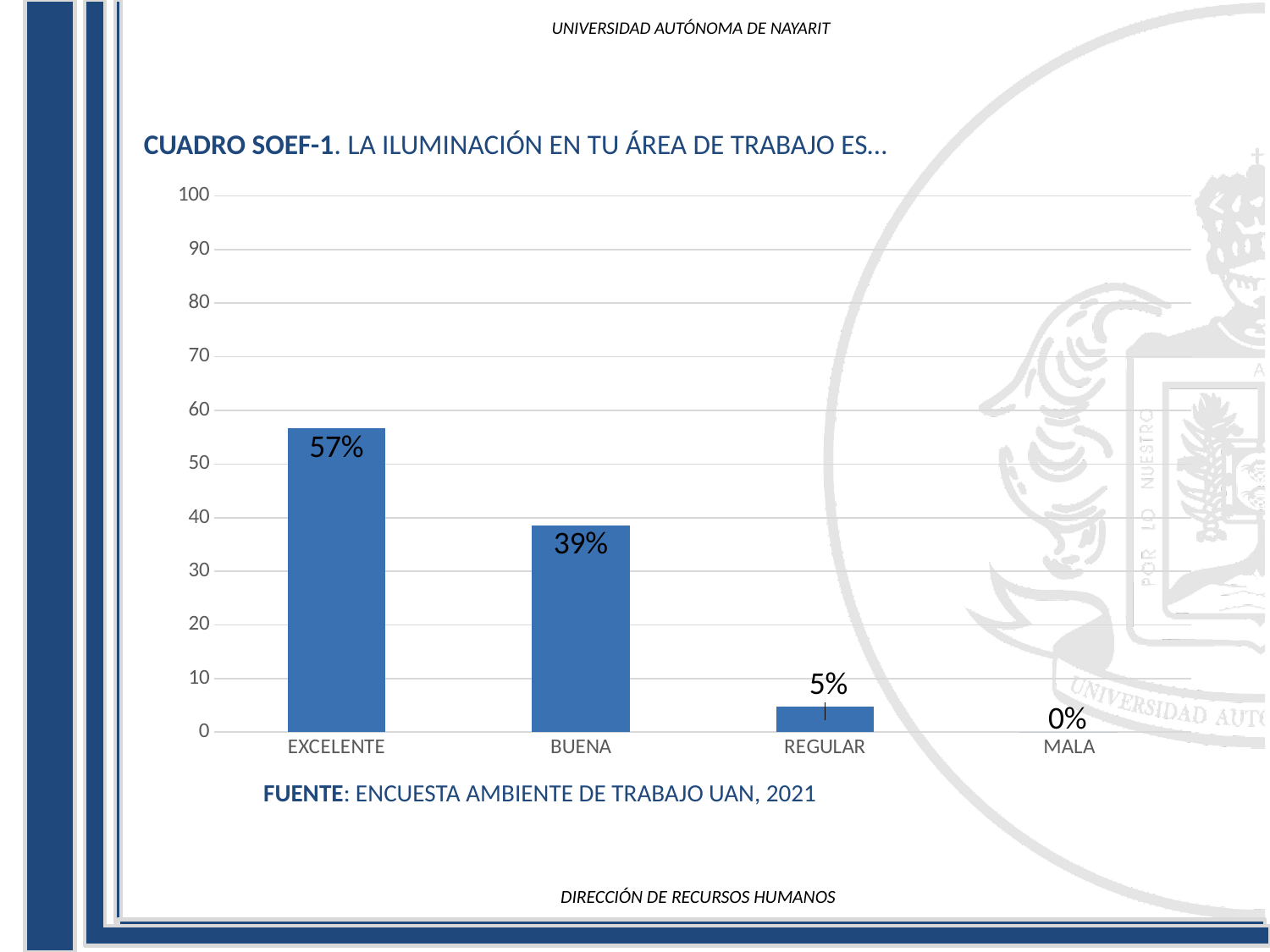
Which category has the lowest value? MALA What is the value for BUENA? 39% What is the value for MALA? 0% Do the values rise or fall from left to right along the x axis? fall How many categories are shown on the x axis? 4 What is the difference between the values for EXCELENTE and BUENA? 18% Is the value for EXCELENTE greater or less than 50? greater What kind of chart is shown on the slide? bar chart What is the value for EXCELENTE? 57% Which category has the highest value? EXCELENTE Which is larger, the value for BUENA or the value for REGULAR? BUENA What is the value for REGULAR? 5%